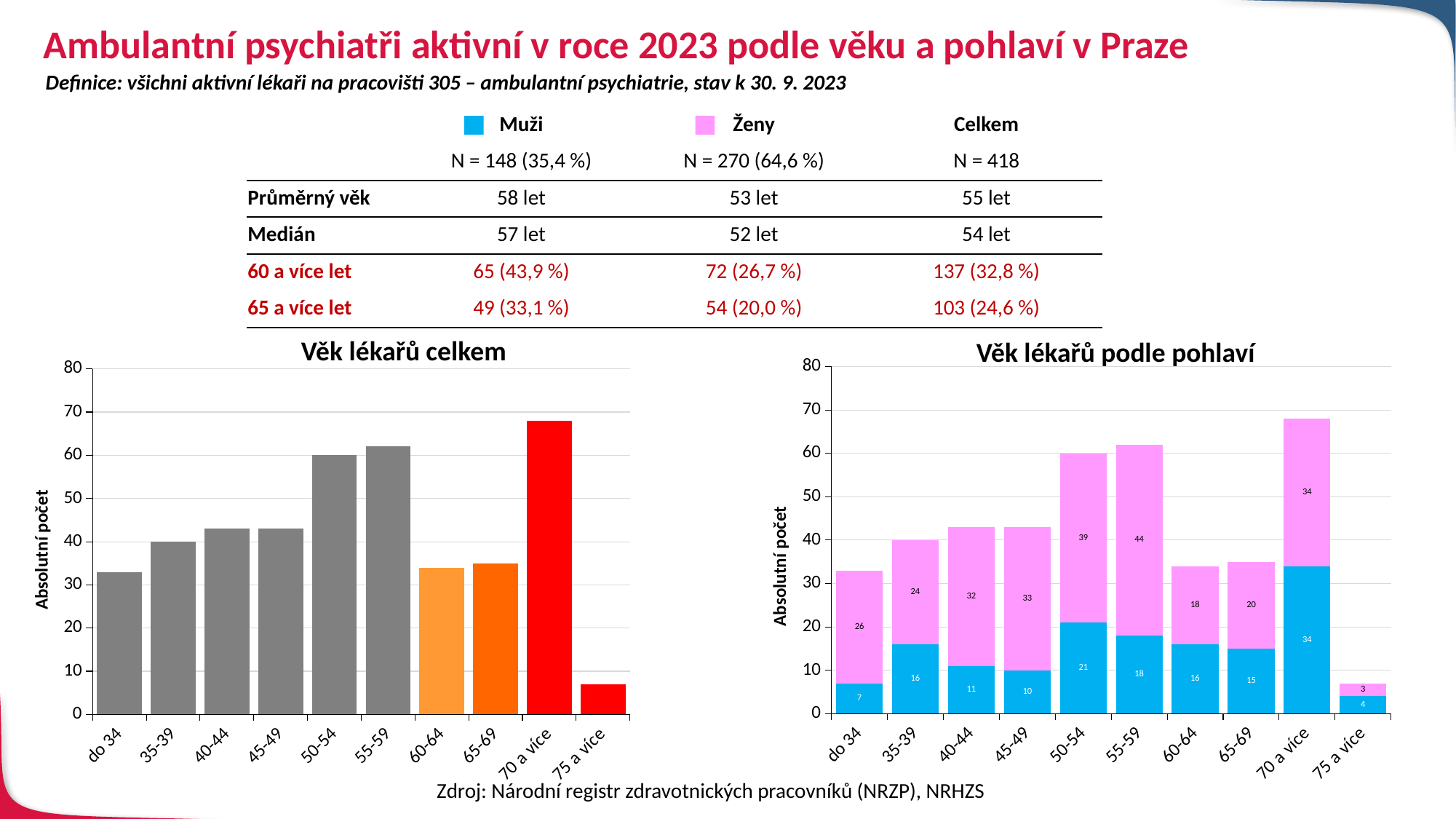
In the chart 'Věk lékařů celkem', which age group has the highest bar? 70 a více In the chart 'Věk lékařů podle pohlaví', what is the total of the stacked bar for '70 a více'? 68 In the chart 'Věk lékařů podle pohlaví', how much larger is the Ženy value than the Muži value in the 'do 34' age group? 19 In the chart 'Věk lékařů celkem', is the value for '75 a více' greater or less than 10? less What kind of chart is 'Věk lékařů celkem'? bar chart How many series are shown in the chart 'Věk lékařů podle pohlaví'? 2 How many age categories are shown on the x axis of the chart 'Věk lékařů celkem'? 10 In the chart 'Věk lékařů podle pohlaví', which age group has the lowest value for Muži? 75 a více In the chart 'Věk lékařů podle pohlaví', what is the value for Muži in the 50-54 age group? 21 In the chart 'Věk lékařů podle pohlaví', which has the larger Muži value: '70 a více' or '50-54'? 70 a více In the chart 'Věk lékařů podle pohlaví', what is the value for Ženy in the 55-59 age group? 44 In the chart 'Věk lékařů podle pohlaví', which age group has the highest value for Ženy? 55-59